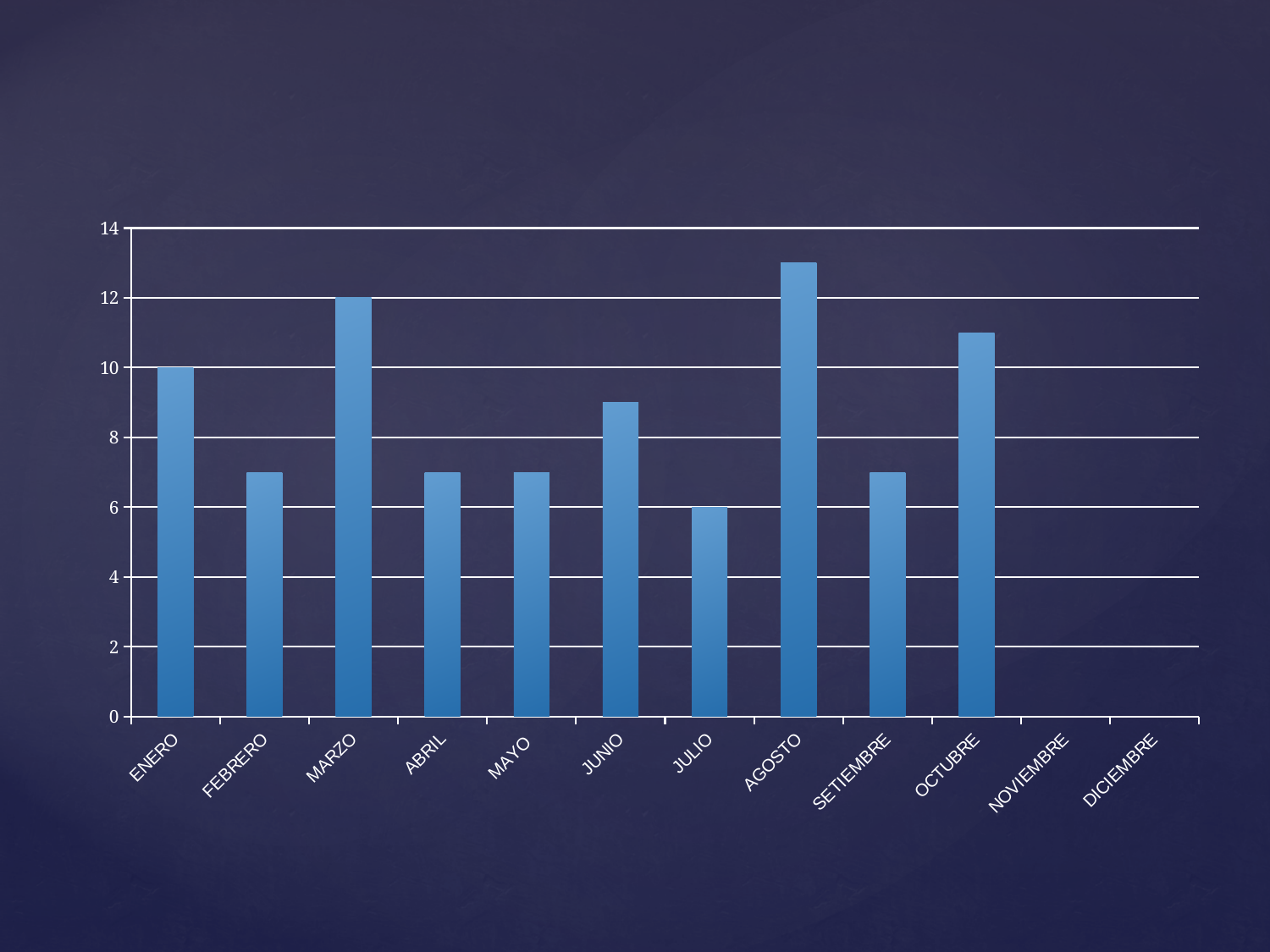
What is the difference between the values for MARZO and ENERO? 2 What is the value for JULIO? 6 Which is larger, the value for MARZO or the value for ENERO? MARZO What is the value for MARZO? 12 Is the value for FEBRERO greater or less than 8? less How many month categories are shown on the x axis? 12 Among the months with a bar, which has the lowest value? JULIO What is the value for ENERO? 10 Is the value for AGOSTO greater or less than 12? greater What is the difference between the values for ENERO and JULIO? 4 What kind of chart is shown on the slide? bar chart Which month has the highest bar? AGOSTO